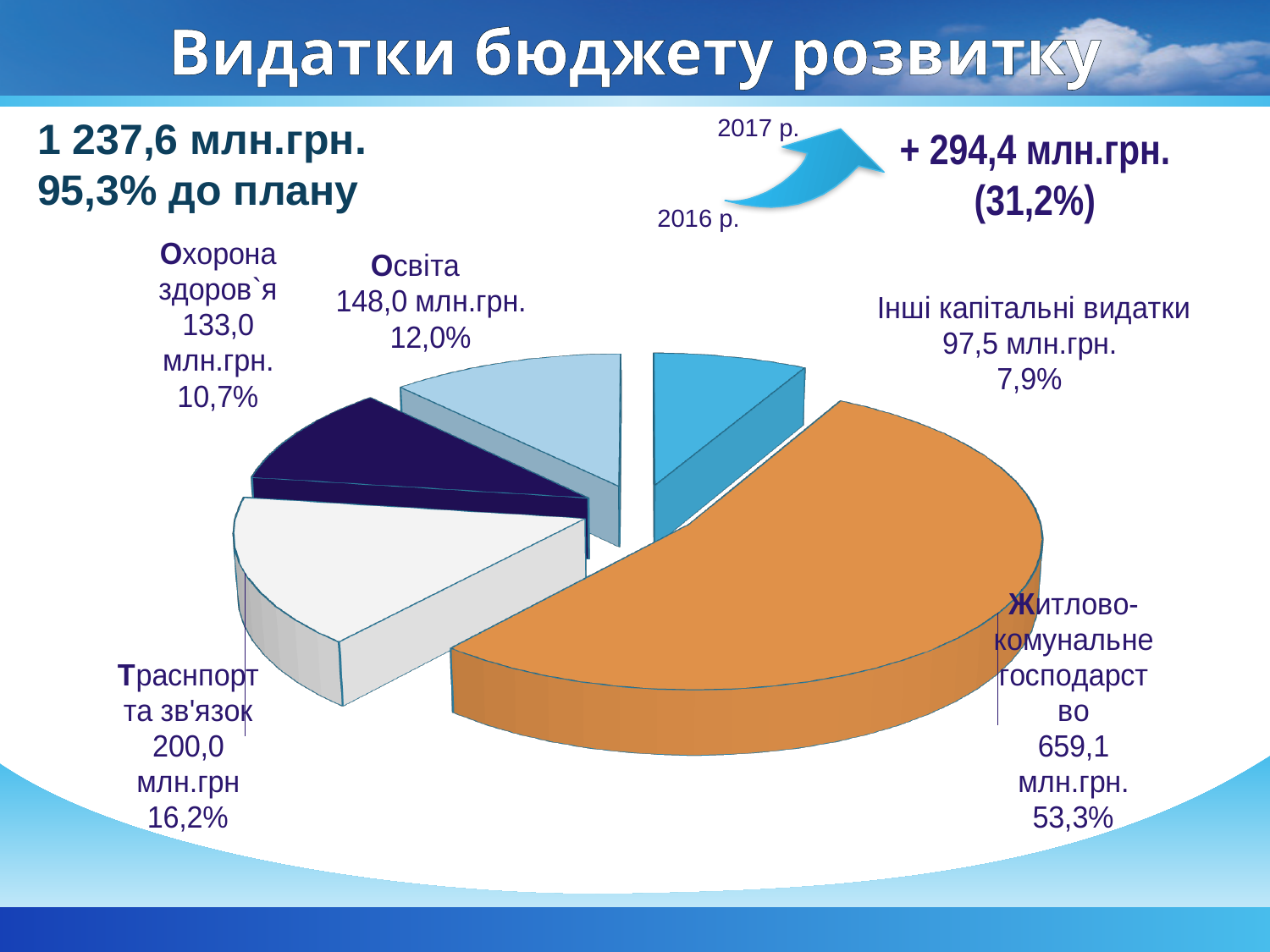
What is the value for Охорона здоров`я? 133,0 млн.грн. What share of the pie does Інші капітальні видатки represent? 7,9% Which category has the smallest slice of the pie? Інші капітальні видатки How many slices does the pie chart have? 5 What kind of chart is shown on the slide? pie chart What is the difference between the values for Траснпорт та зв'язок and Освіта? 52,0 млн.грн. Which is larger, the value for Освіта or the value for Охорона здоров`я? Освіта Which category has the largest slice of the pie? Житлово-комунальне господарство What share of the pie does Освіта represent? 12,0% What is the value for Житлово-комунальне господарство? 659,1 млн.грн. What is the value for Траснпорт та зв'язок? 200,0 млн.грн What is the title of the slide containing the pie chart? Видатки бюджету розвитку